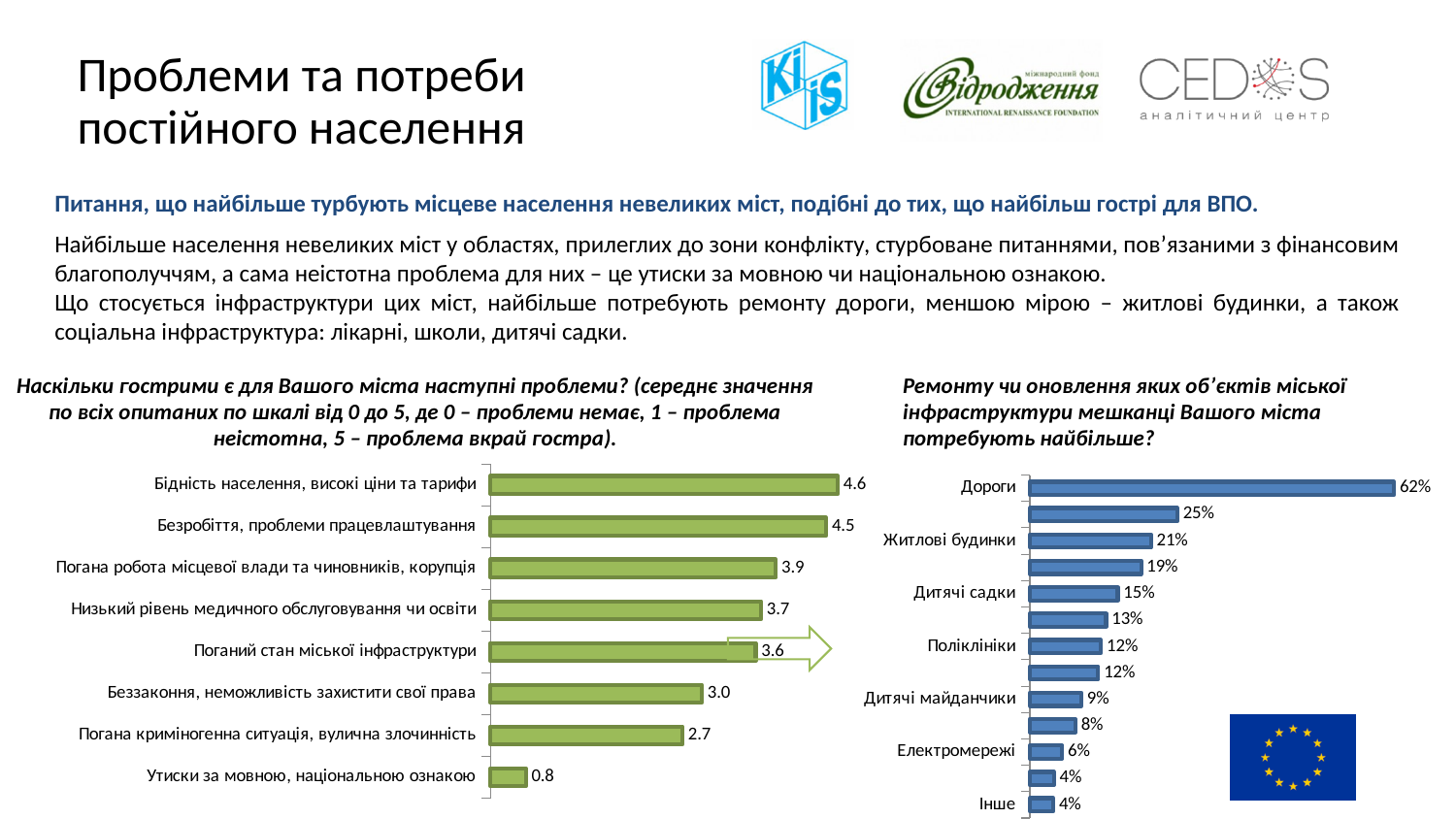
On the right chart, what is the value for "Електромережі"? 6% On the right chart ("Ремонту чи оновлення яких об'єктів міської інфраструктури..."), what is the value for "Дороги"? 62% On the left chart, what is the value for "Поганий стан міської інфраструктури"? 3.6 What type of chart is the left chart? Bar chart On the right chart, which is larger: the value for "Житлові будинки" or the value for "Поліклініки"? Житлові будинки On the left chart, which problem has the highest value? Бідність населення, високі ціни та тарифи On the left chart, which problem has the lowest value? Утиски за мовною, національною ознакою On the left chart ("Наскільки гострими є для Вашого міста наступні проблеми?"), what is the value for "Бідність населення, високі ціни та тарифи"? 4.6 On the right chart, what is the value for "Дитячі садки"? 15% On the right chart, what is the difference between the values for "Дороги" and "Житлові будинки"? 41% On the left chart, what is the difference between the values for "Безробіття, проблеми працевлаштування" and "Погана криміногенна ситуація, вулична злочинність"? 1.8 On the left chart, how many problems (categories) are plotted? 8